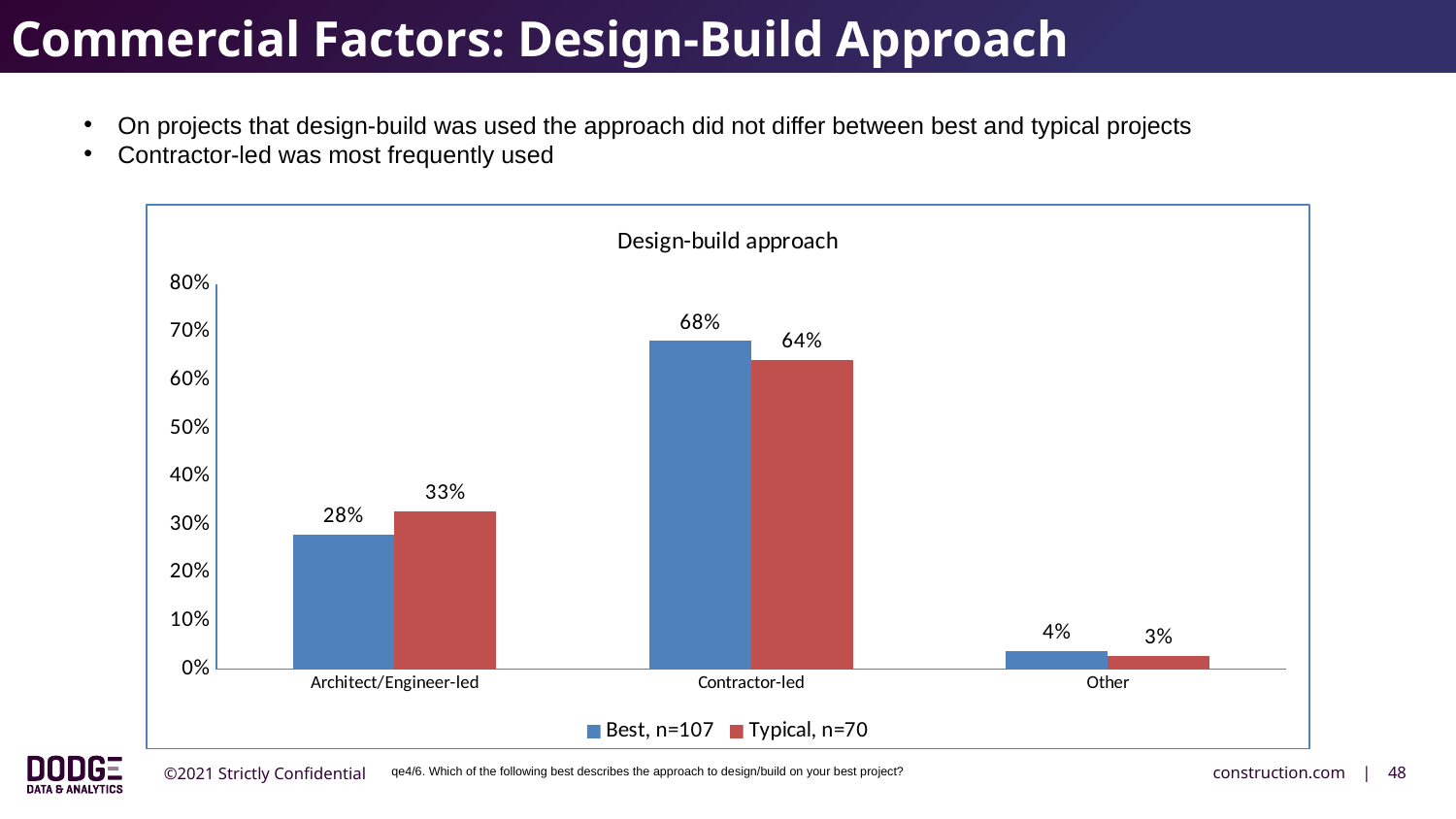
What is the value for Contractor-led in the Best, n=107 series? 68% What is the title of the chart? Design-build approach How many categories are shown on the x axis? 3 What kind of chart is shown on the slide? Bar chart Which category has the highest value in the Typical, n=70 series? Contractor-led What is the value for Architect/Engineer-led in the Typical, n=70 series? 33% For Architect/Engineer-led, which series has the larger value: Best, n=107 or Typical, n=70? Typical, n=70 Is the Typical, n=70 value for Contractor-led greater or less than 50%? greater Which category has the lowest value in the Best, n=107 series? Other How many series does the legend list? 2 What is the difference between the Best, n=107 and Typical, n=70 values for Contractor-led? 4% What is the value for Other in the Best, n=107 series? 4%